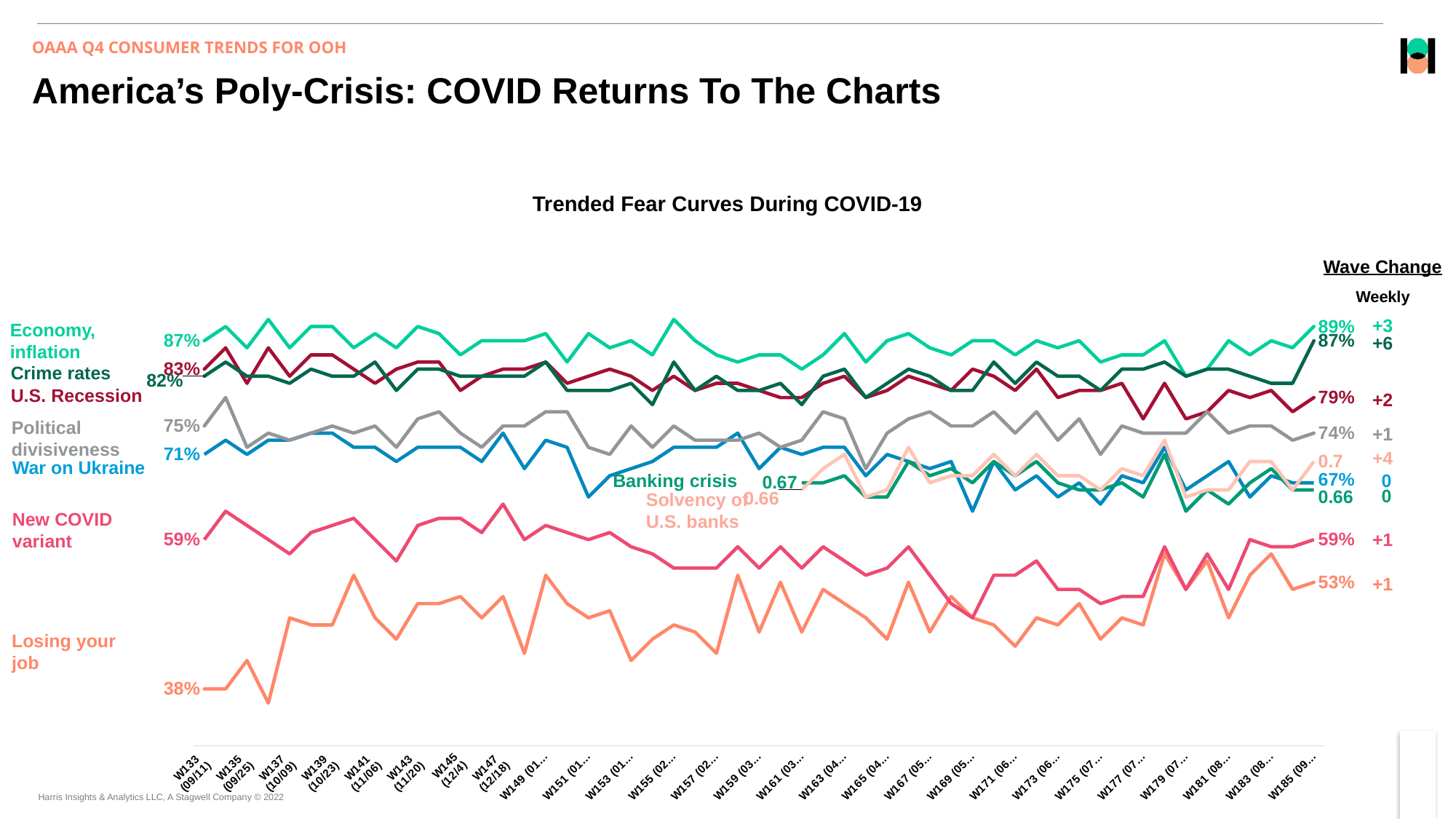
By how many percentage points did Losing your job rise from its starting value of 38% to its latest value of 53%? 15 percentage points Which series has the highest value at the right end of the chart? Economy, inflation What type of chart is shown on the slide? line chart What is the weekly wave change shown for Crime rates? +6 At the right end of the chart, which is larger: the value for U.S. Recession or the value for Political divisiveness? U.S. Recession Which series has the lowest value at the left start of the chart? Losing your job Does the Losing your job line generally rise or fall from left to right across the chart? rise What is the latest value shown for Losing your job? 53% What is the weekly wave change shown for Solvency of U.S. banks? +4 What is the latest value shown for Economy, inflation? 89% What is the title of the chart? Trended Fear Curves During COVID-19 What is the starting value shown for Losing your job at the left of the chart? 38%